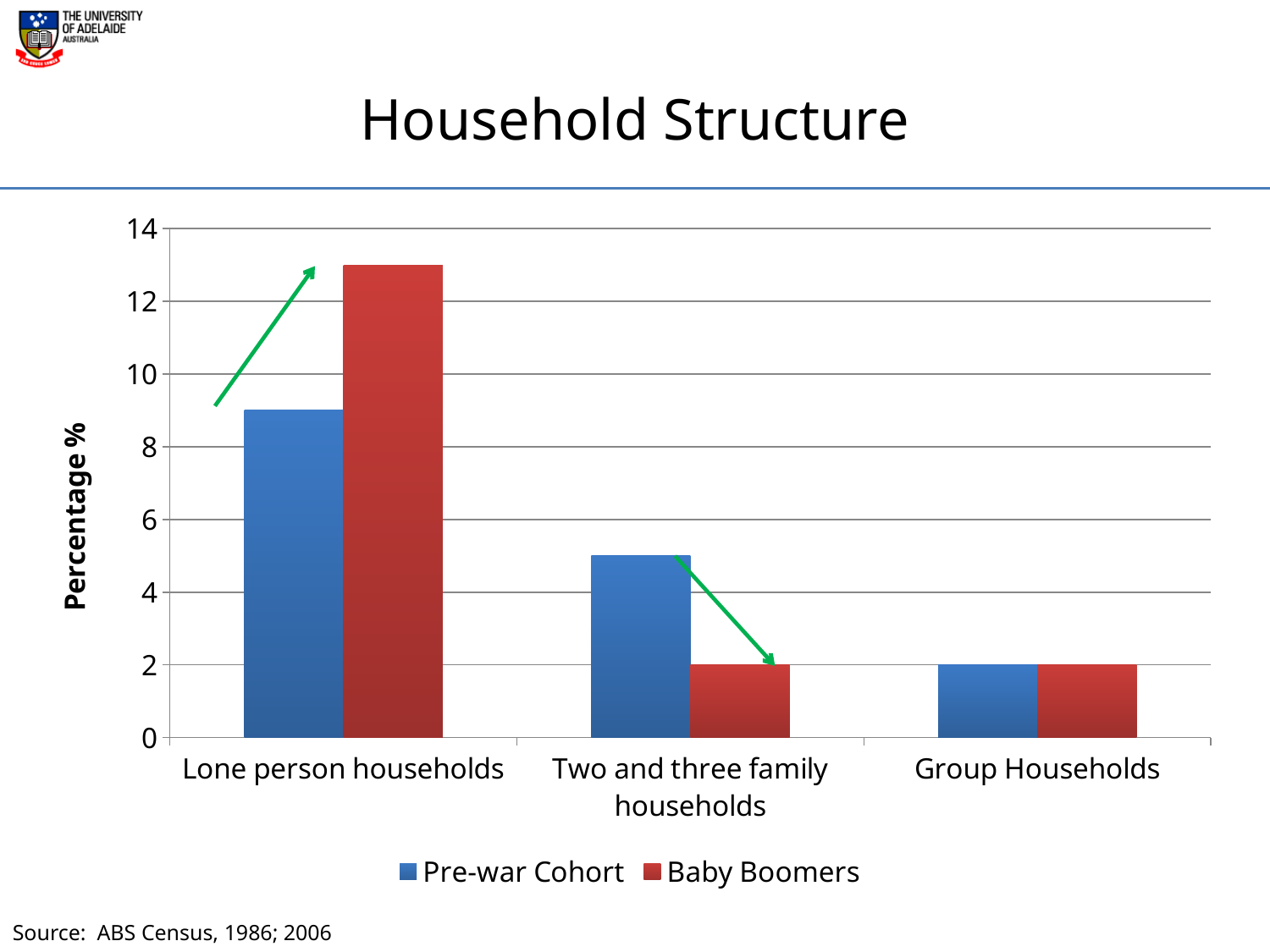
Is the Pre-war Cohort value for Two and three family households greater or less than 4? greater What is the Baby Boomers value for Two and three family households? 2 What kind of chart is shown on the slide? bar chart What is the Pre-war Cohort value for Group Households? 2 Which category has the lowest Pre-war Cohort value? Group Households How many series does the legend list? 2 For Two and three family households, which is larger: the Pre-war Cohort value or the Baby Boomers value? Pre-war Cohort Is the Baby Boomers value for Lone person households greater or less than 12? greater Which category has the highest Baby Boomers value? Lone person households Is the Pre-war Cohort value for Lone person households greater or less than 10? less How many household categories are shown on the x axis? 3 What is the label on the vertical axis? Percentage %